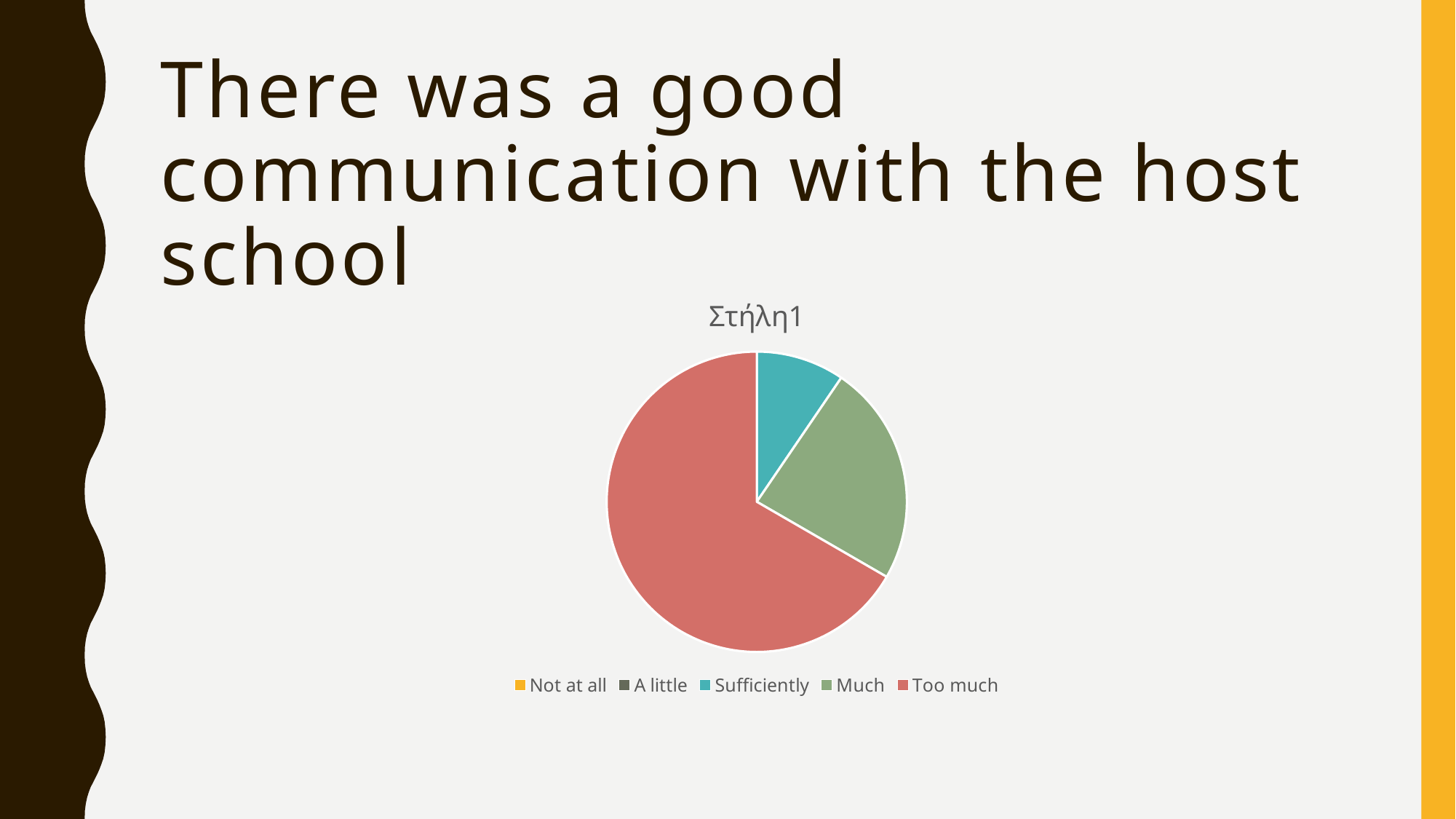
How many slices are visible in the pie? 3 How many categories does the legend list? 5 Which is larger, the slice for Much or the slice for Sufficiently? Much Which is larger, the slice for Too much or the slice for Much? Too much What colour is the slice for Too much? red Which category has the largest slice of the pie? Too much What kind of chart is shown on the slide? pie chart Does the Too much slice take up more or less than half of the pie? more What is the title of the chart? Στήλη1